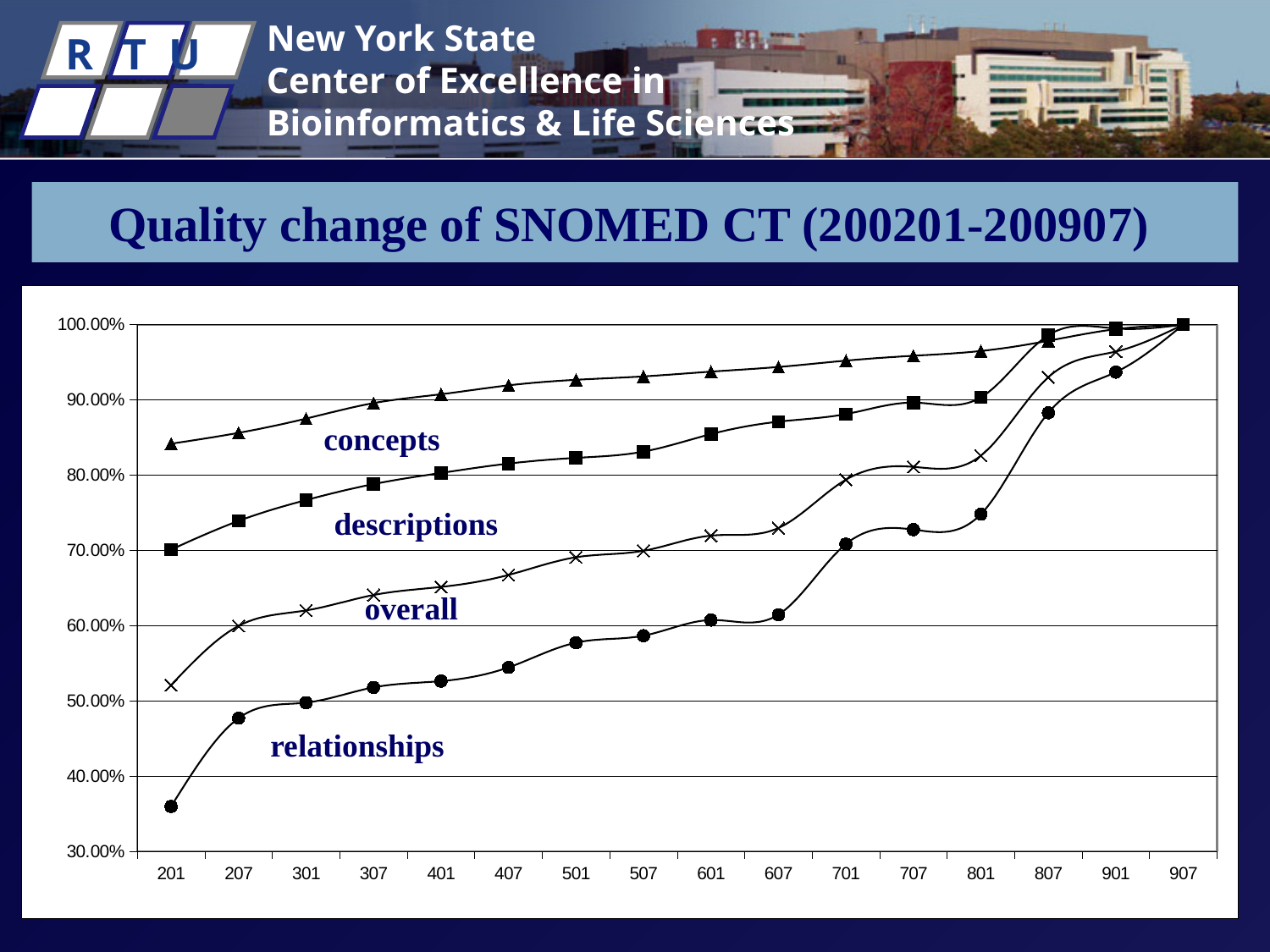
Is the value for concepts at 201 greater or less than 80.00%? greater Which series has the highest value at 201? concepts Which series has the lowest value at 201? relationships How many series are labelled on the chart? 4 How many points are marked along the x axis of the chart? 16 Is the value for relationships at 801 greater or less than 70.00%? greater Is the value for relationships at 201 greater or less than 40.00%? less Do the values of the relationships series rise or fall from 201 to 907? rise What is the title of the chart on the slide? Quality change of SNOMED CT (200201-200907) What kind of chart is shown on the slide? line chart At 401, which series has the larger value, descriptions or overall? descriptions